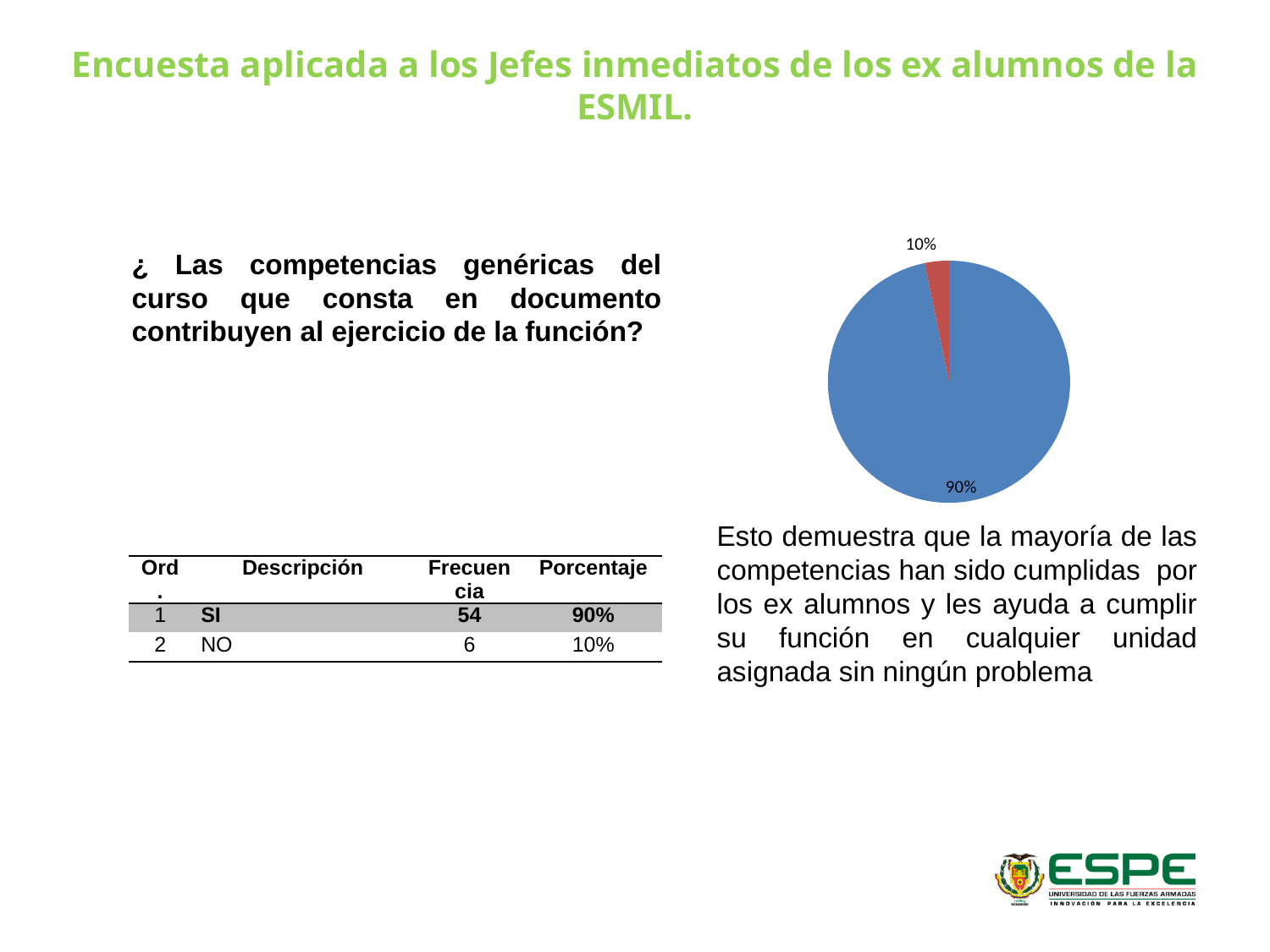
What percentage is shown for the largest slice of the pie chart? 90% What kind of chart is shown on the slide? pie chart What colour is the slice labelled 10% in the pie chart? red What percentage is shown for the smallest slice of the pie chart? 10% Is the share of the blue slice in the pie chart greater or less than 50%? greater What is the total of the two percentages shown on the pie chart? 100% How many slices does the pie chart have? 2 What colour is the slice labelled 90% in the pie chart? blue According to the table on the slide, what frequency corresponds to the 10% slice of the pie chart? 6 According to the table on the slide, which response corresponds to the 90% slice of the pie chart? SI Which slice of the pie chart is larger, the blue one or the red one? the blue one What is the difference in percentage points between the two slices of the pie chart? 80